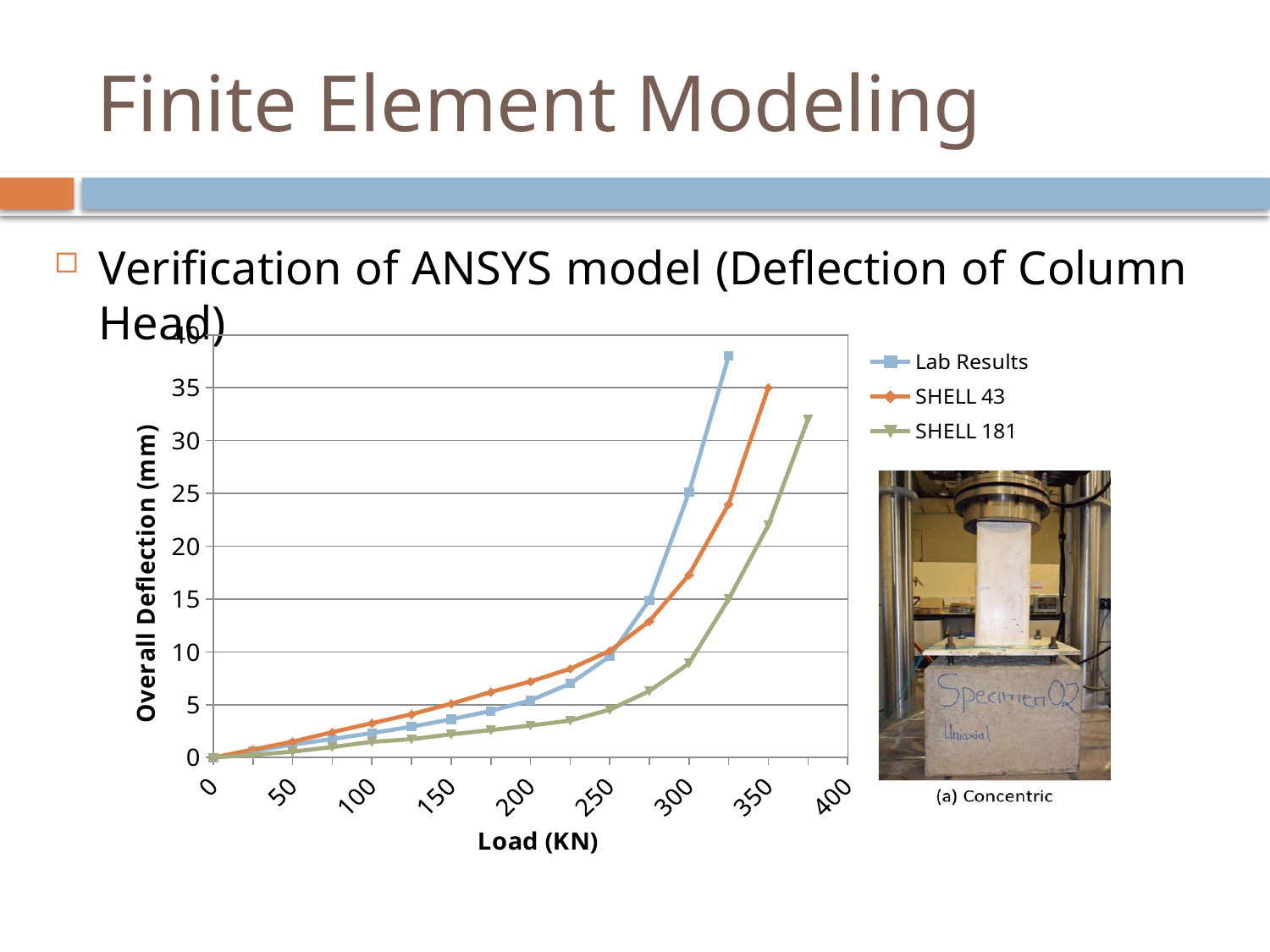
Is the Lab Results deflection at a load of 200 KN greater or less than 10 mm? less Is the Lab Results deflection at a load of 300 KN greater or less than 20 mm? greater Is the SHELL 181 deflection at a load of 250 KN greater or less than 10 mm? less What is the title of the horizontal axis of the chart? Load (KN) What kind of chart is shown on the slide? Line chart How many series does the chart's legend list? 3 Does the overall deflection rise or fall as the load increases along the x axis? Rises At a load of 150 KN, which series shows the larger deflection, SHELL 43 or SHELL 181? SHELL 43 At a load of 300 KN, which series shows the larger deflection, Lab Results or SHELL 181? Lab Results What is the title of the vertical axis of the chart? Overall Deflection (mm)